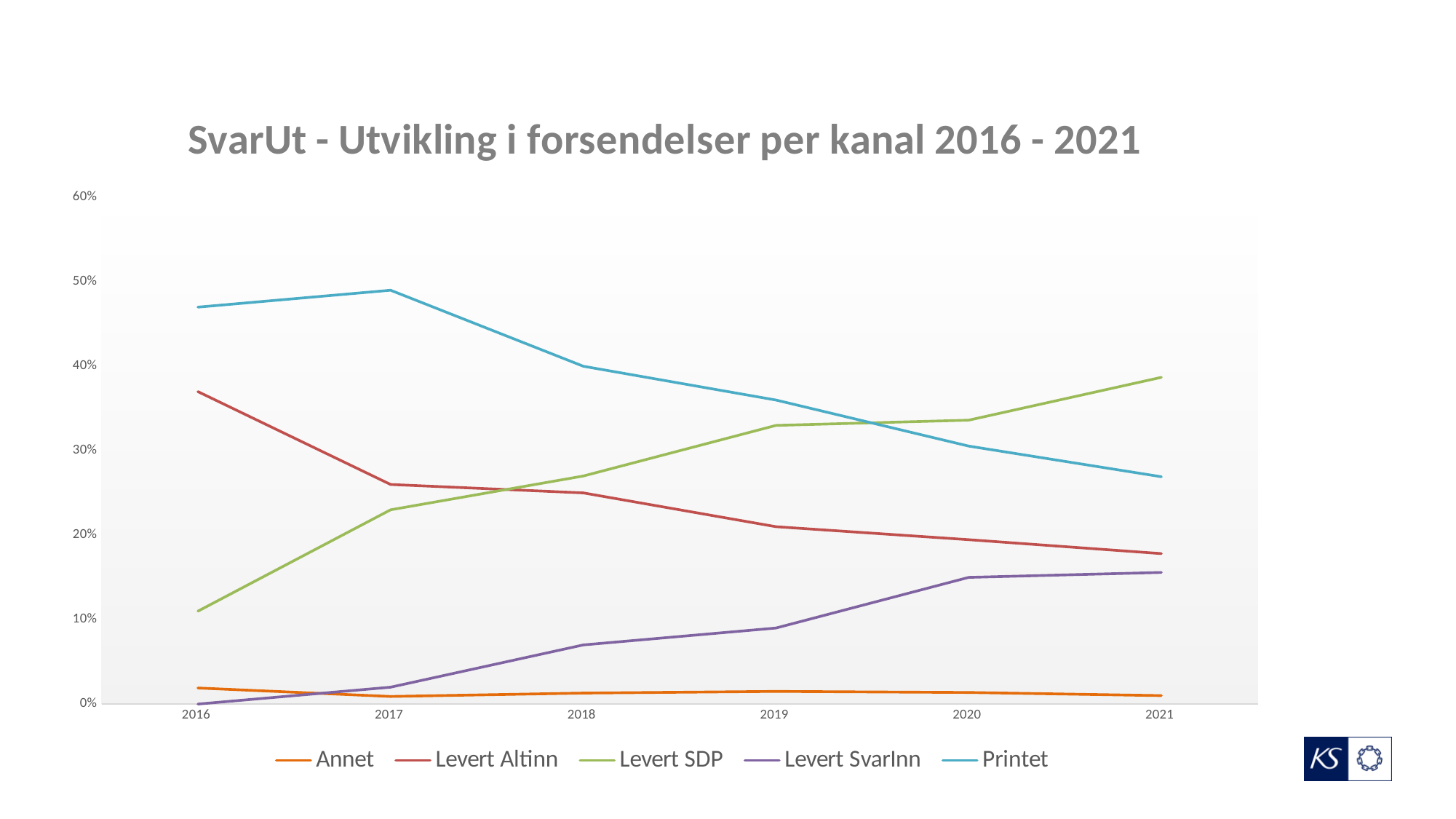
How many series does the legend list? 5 Which series has the highest value in 2016? Printet Does the Levert SDP series rise or fall from 2016 to 2021? rise How many years are plotted along the x axis? 6 What kind of chart is shown on the slide? line chart Which series has the highest value in 2021? Levert SDP Is the value for Printet in 2017 greater or less than 40%? greater In 2019, which is larger: Levert SDP or Levert Altinn? Levert SDP Which series has the lowest value in 2021? Annet Does the Printet series rise or fall from 2017 to 2021? fall Is the value for Levert SDP in 2016 greater or less than 20%? less What is the title of the chart? SvarUt - Utvikling i forsendelser per kanal 2016 - 2021